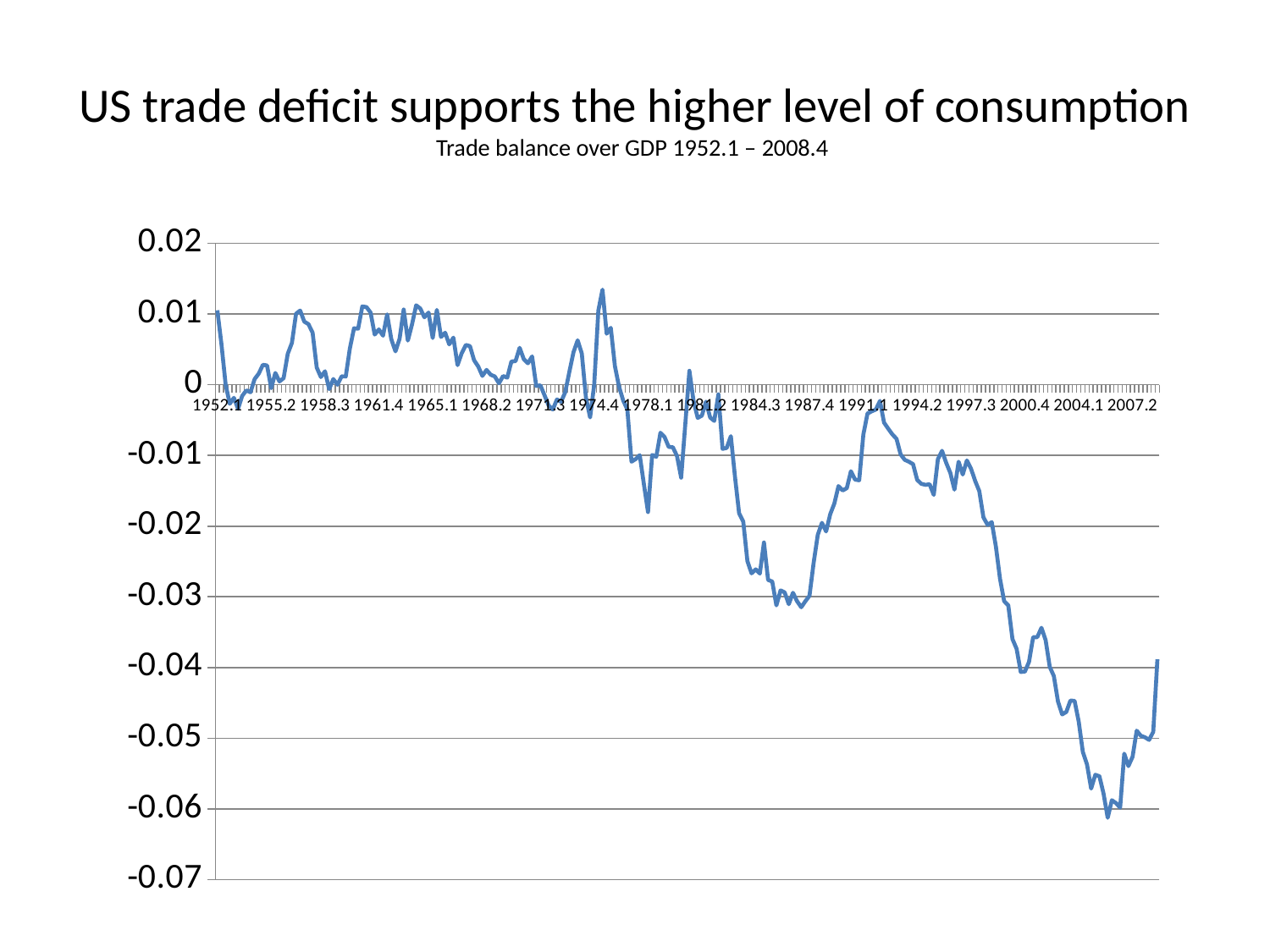
What period does the chart subtitle say the trade balance over GDP covers? 1952.1 – 2008.4 Overall, does the trade balance over GDP rise or fall from 1952.1 to 2008.4? fall Is the value at 2007.2 greater or less than -0.04? less Is the highest value reached by the line greater or less than 0.01? greater What is the title of the slide? US trade deficit supports the higher level of consumption Is the value at 1961.4 greater or less than 0? greater What kind of chart is shown on the slide? line chart